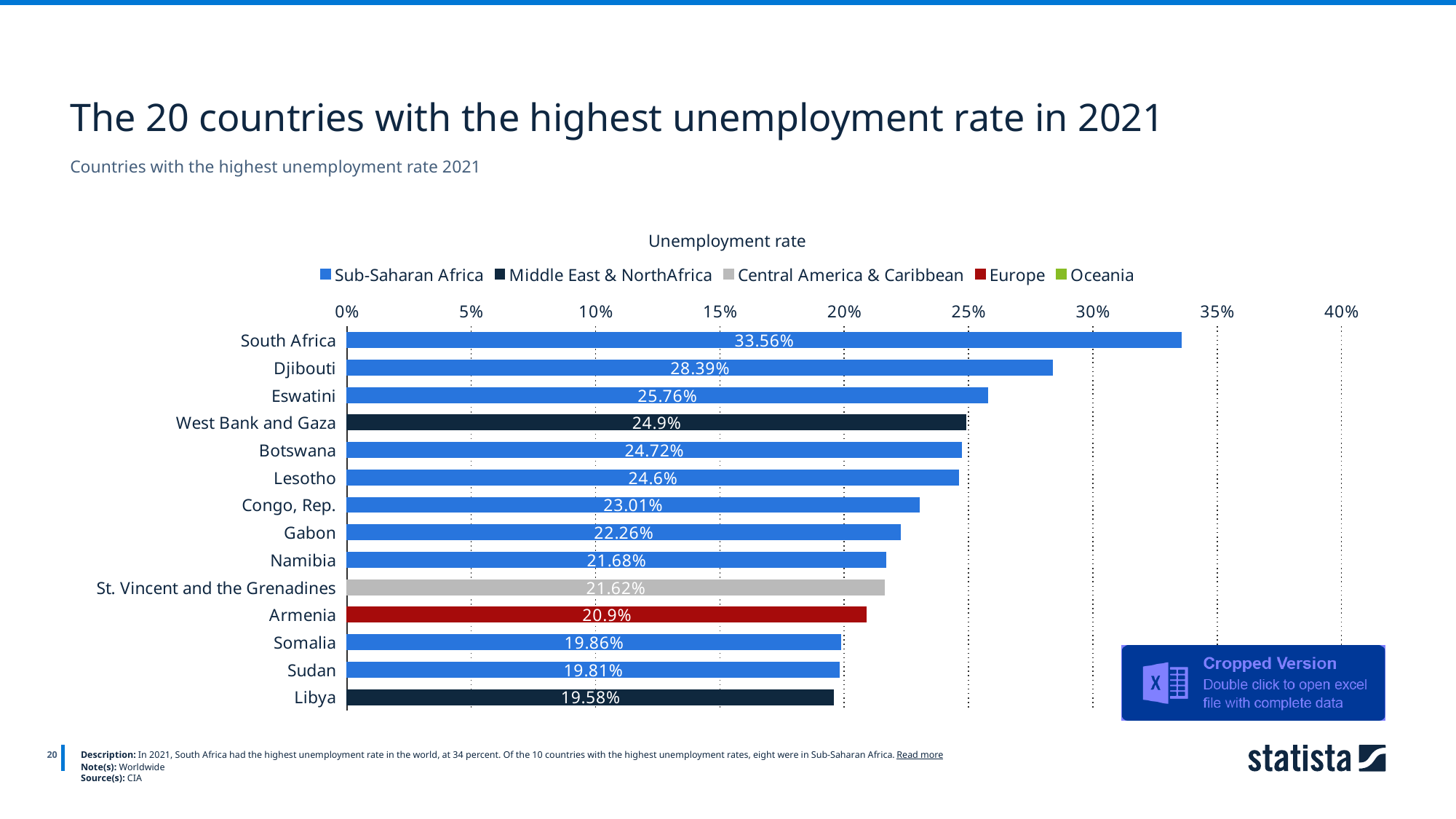
Is the value for Congo, Rep. greater or less than 20%? greater Which country has the lowest unemployment rate among those shown on the chart? Libya Which has a higher unemployment rate, Djibouti or Eswatini? Djibouti What is the unemployment rate shown for South Africa? 33.56% How many series does the legend list? 5 What is the unemployment rate shown for West Bank and Gaza? 24.9% Which country has the highest unemployment rate on the chart? South Africa What type of chart is shown on the slide? Bar chart How many countries are shown on the chart? 14 Which region does the legend associate with the red bar (Armenia)? Europe What is the difference in percentage points between the unemployment rates of South Africa and Djibouti? 5.17 What is the unemployment rate shown for St. Vincent and the Grenadines? 21.62%